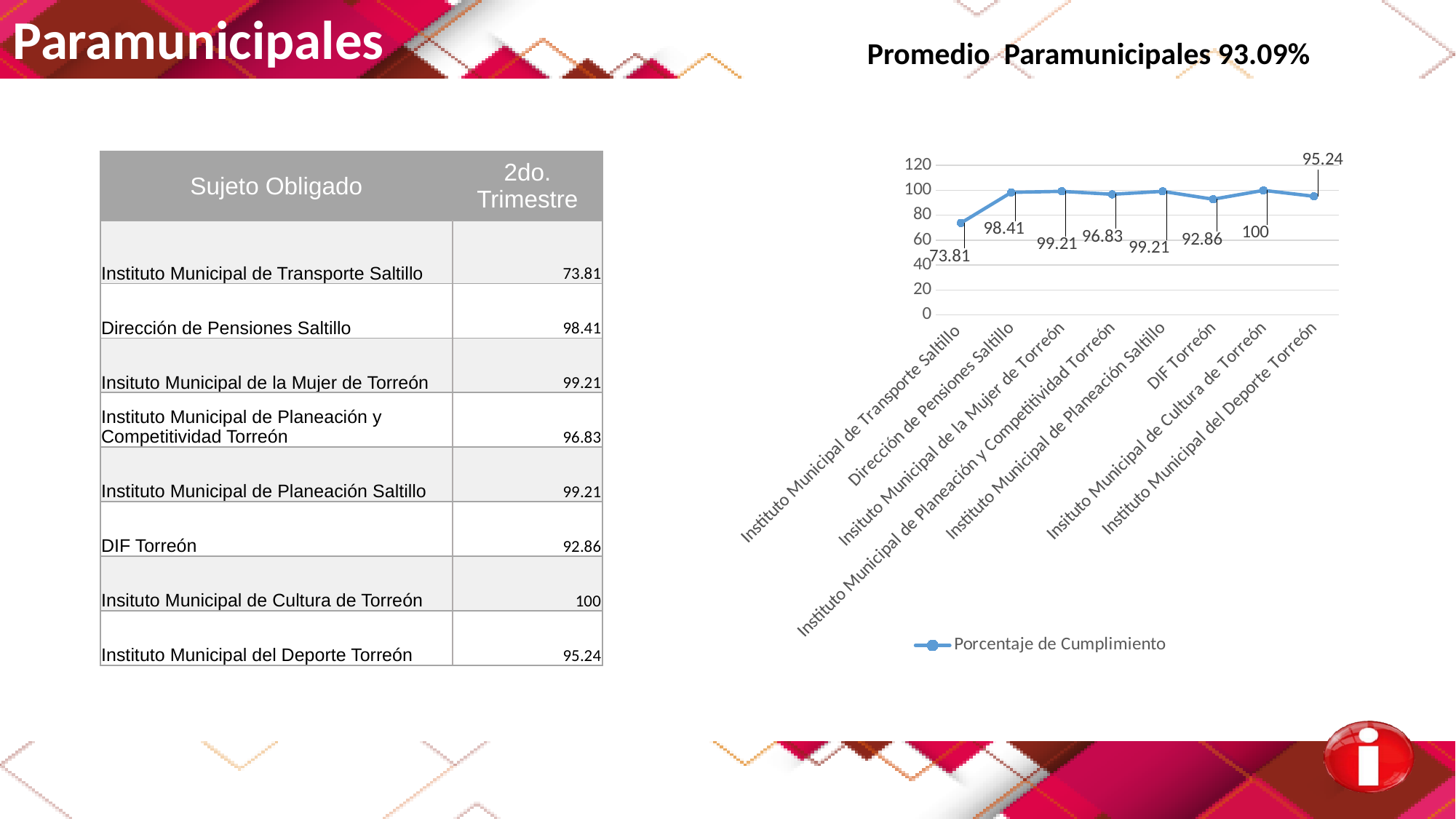
Which is larger: the value for DIF Torreón or the value for Instituto Municipal del Deporte Torreón? Instituto Municipal del Deporte Torreón How many categories are plotted in the chart? 8 Which category has the highest value in the chart? Insituto Municipal de Cultura de Torreón Is the value for Instituto Municipal de Transporte Saltillo greater or less than 80? less What is the difference between the values for Dirección de Pensiones Saltillo and Instituto Municipal de Transporte Saltillo? 24.6 Which category has the lowest value in the chart? Instituto Municipal de Transporte Saltillo What is the value for Instituto Municipal del Deporte Torreón in the chart? 95.24 What is the name of the series shown in the chart legend? Porcentaje de Cumplimiento What kind of chart is shown on the slide? line chart How many series does the chart legend list? 1 What is the value for DIF Torreón in the chart? 92.86 What is the value for Instituto Municipal de Transporte Saltillo in the chart? 73.81